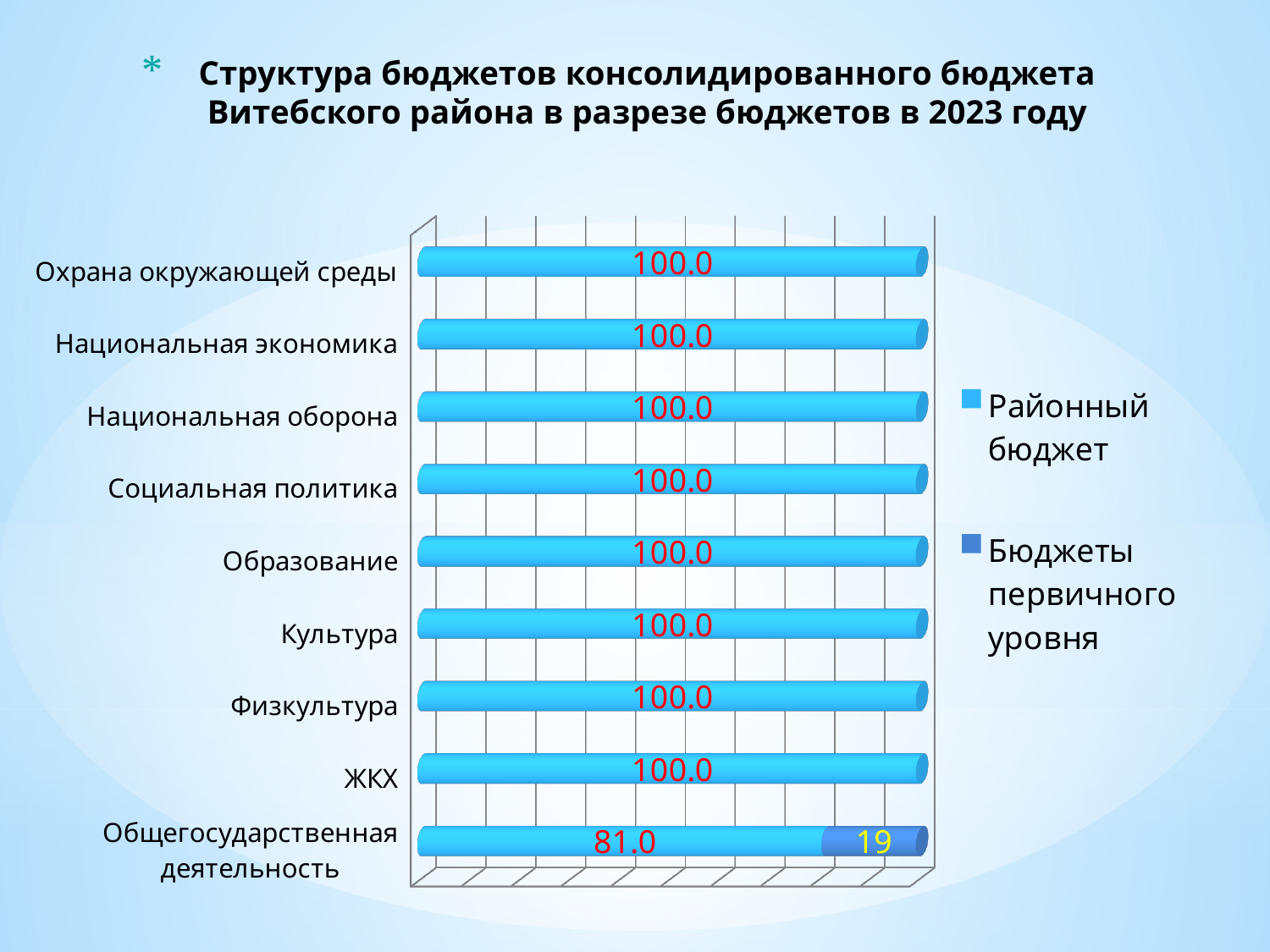
Which category has the lowest value for Районный бюджет? Общегосударственная деятельность What is the value of Районный бюджет for Образование? 100.0 What is the difference between the Районный бюджет values for Культура and Общегосударственная деятельность? 19.0 How many categories are shown on the chart? 9 What is the value of Районный бюджет for Общегосударственная деятельность? 81.0 Which is larger for Общегосударственная деятельность: Районный бюджет or Бюджеты первичного уровня? Районный бюджет How many series does the legend list? 2 What is the value of Районный бюджет for ЖКХ? 100.0 What is the total of the stacked bar for Общегосударственная деятельность? 100.0 What kind of chart is shown on the slide? bar chart What are the two series listed in the legend? Районный бюджет; Бюджеты первичного уровня What is the value of Бюджеты первичного уровня for Общегосударственная деятельность? 19